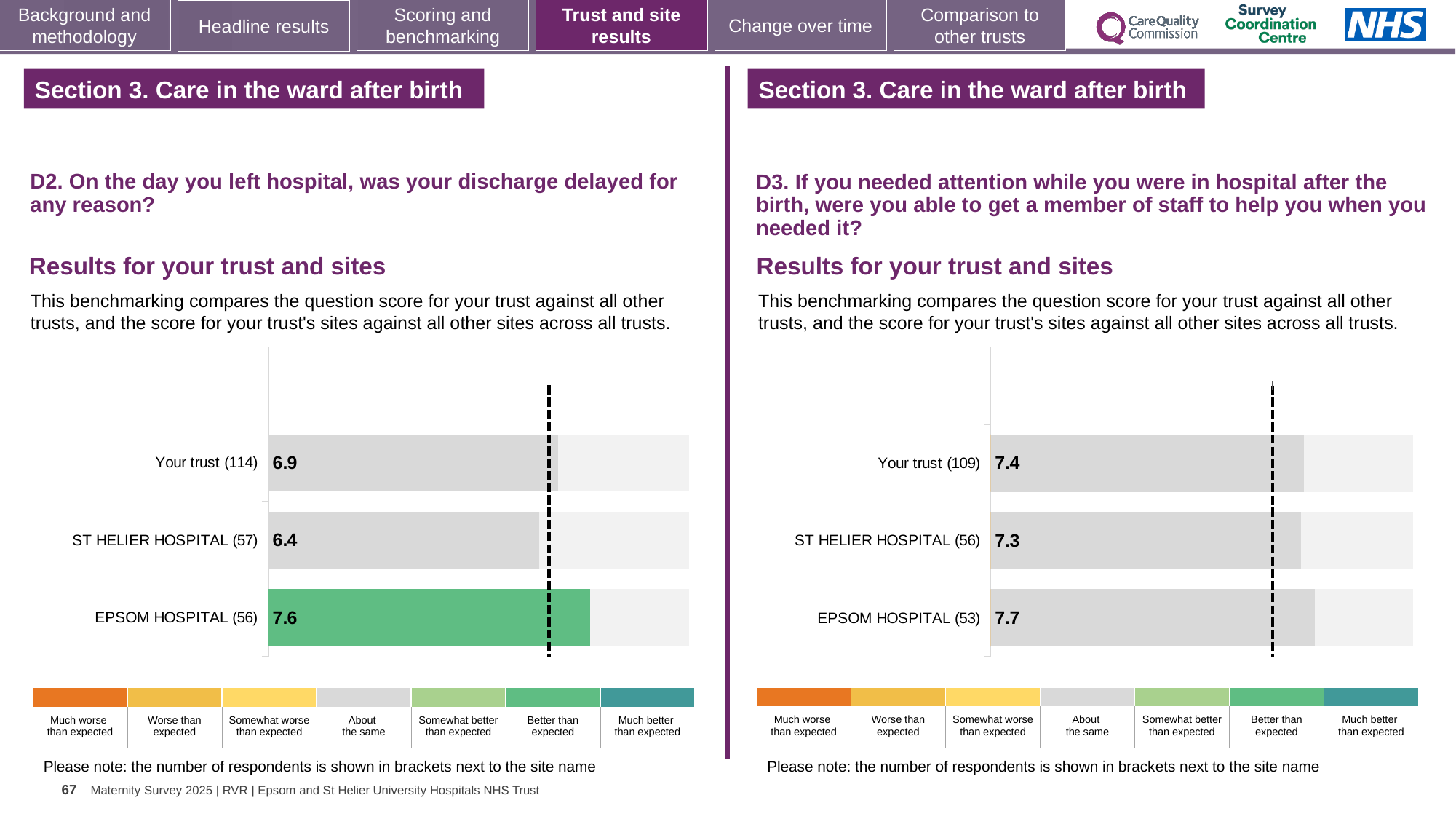
In the D3 chart (right), what is the score for ST HELIER HOSPITAL? 7.3 How many bars are plotted in the D2 chart (left)? 3 In the D3 chart (right), how many respondents are shown in brackets for Your trust? 109 In the D2 chart (left), how many respondents are shown in brackets for ST HELIER HOSPITAL? 57 What type of chart is used in the D3 chart (right)? bar chart In the D3 chart (right), what is the difference between the scores for Your trust and ST HELIER HOSPITAL? 0.1 In the D3 chart (right), which site or trust has the highest score? EPSOM HOSPITAL In the D2 chart (left), which site or trust has the lowest score? ST HELIER HOSPITAL In the D2 chart (left), what is the difference between the scores for EPSOM HOSPITAL and ST HELIER HOSPITAL? 1.2 In the D2 chart (left), what is the score for Your trust? 6.9 In the D3 chart (right), is the score for Your trust larger or smaller than the score for EPSOM HOSPITAL? smaller In the D2 chart (left), what is the score for EPSOM HOSPITAL? 7.6